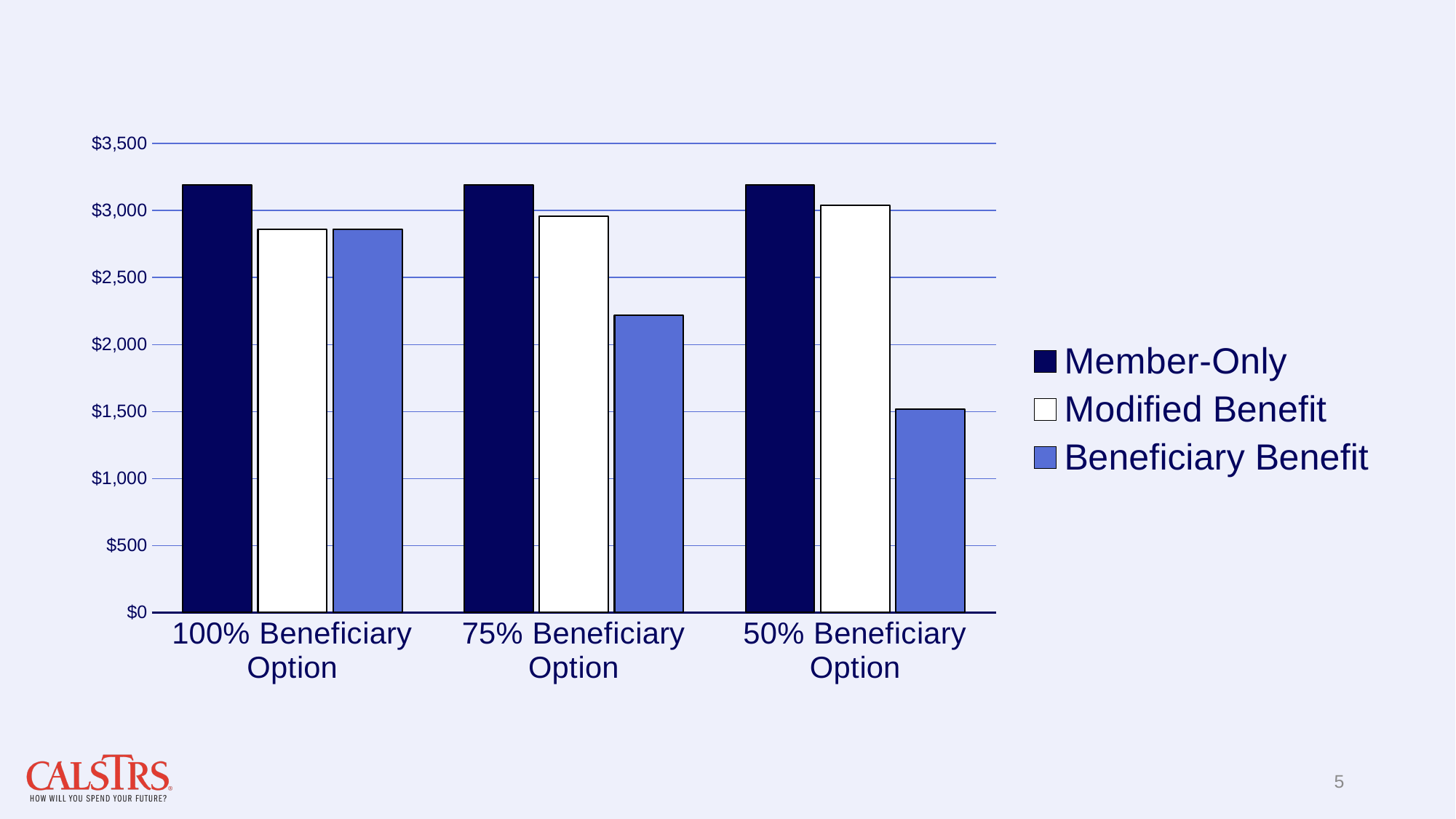
Which category has the highest Beneficiary Benefit value? 100% Beneficiary Option How many categories are shown on the x axis? 3 Is the Modified Benefit value for the 100% Beneficiary Option greater or less than $3,000? less Which series is shown with white bars in the legend? Modified Benefit Is the Beneficiary Benefit value for the 50% Beneficiary Option greater or less than $2,000? less Do the Beneficiary Benefit values rise or fall from the 100% Beneficiary Option to the 50% Beneficiary Option? fall Which is larger for the 50% Beneficiary Option: the Member-Only value or the Beneficiary Benefit value? Member-Only What kind of chart is shown on the slide? bar chart Which category has the lowest Beneficiary Benefit value? 50% Beneficiary Option Is the Member-Only value for the 100% Beneficiary Option greater or less than $3,000? greater How many series does the legend list? 3